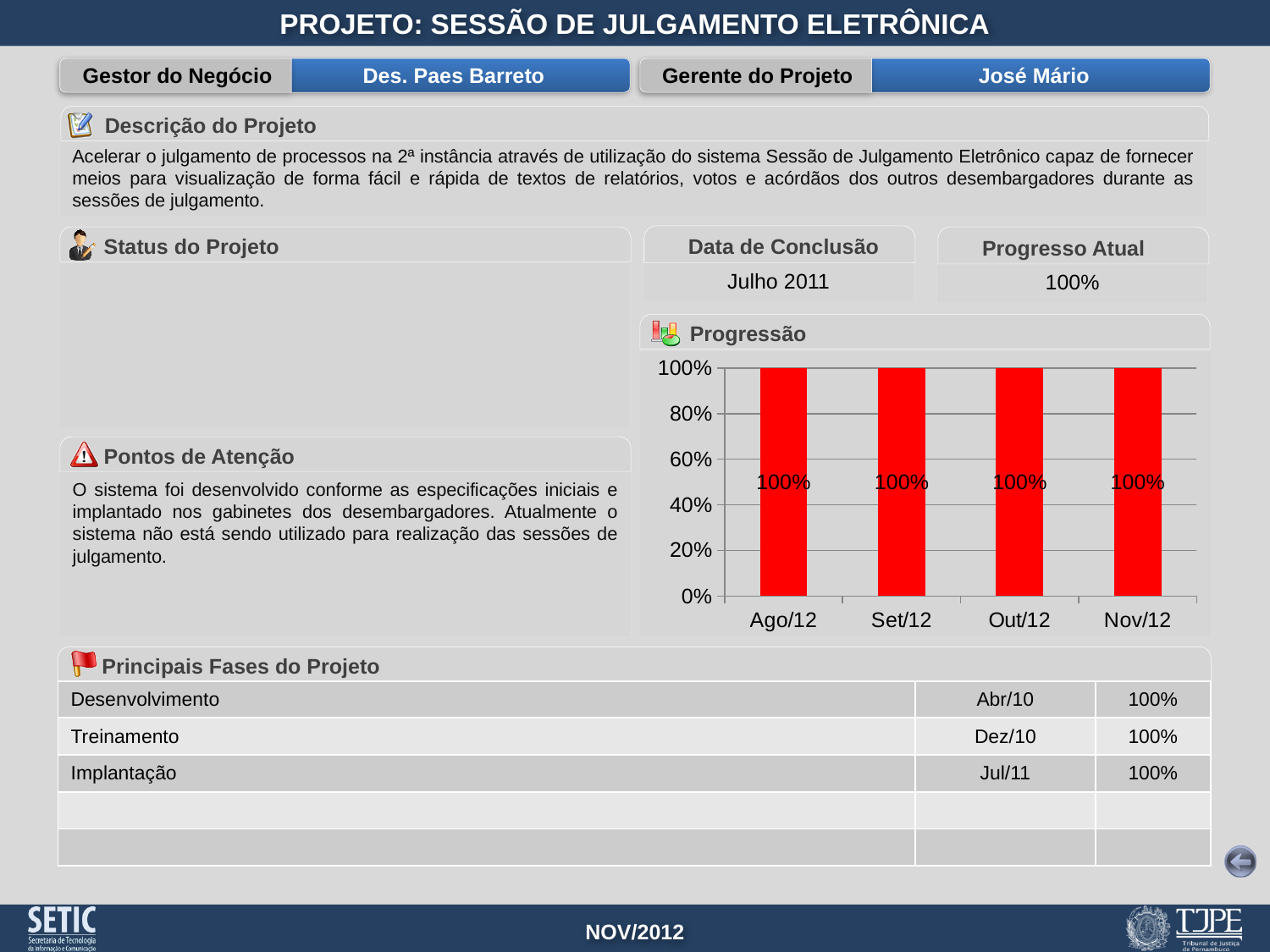
What kind of chart is the Progressão chart? bar chart What is the value for Ago/12 in the Progressão chart? 100% What is the value for Nov/12 in the Progressão chart? 100% What is the difference between the values for Ago/12 and Nov/12 in the Progressão chart? 0% Do the values in the Progressão chart rise, fall or stay the same from Ago/12 to Nov/12? stay the same How many categories are shown on the x axis of the Progressão chart? 4 What is the value for Out/12 in the Progressão chart? 100% Is the value for Set/12 in the Progressão chart greater or less than 80%? greater What is the highest value shown on the y axis of the Progressão chart? 100% What is the value for Set/12 in the Progressão chart? 100% What is the title of the chart on the slide? Progressão What colour are the bars in the Progressão chart? red